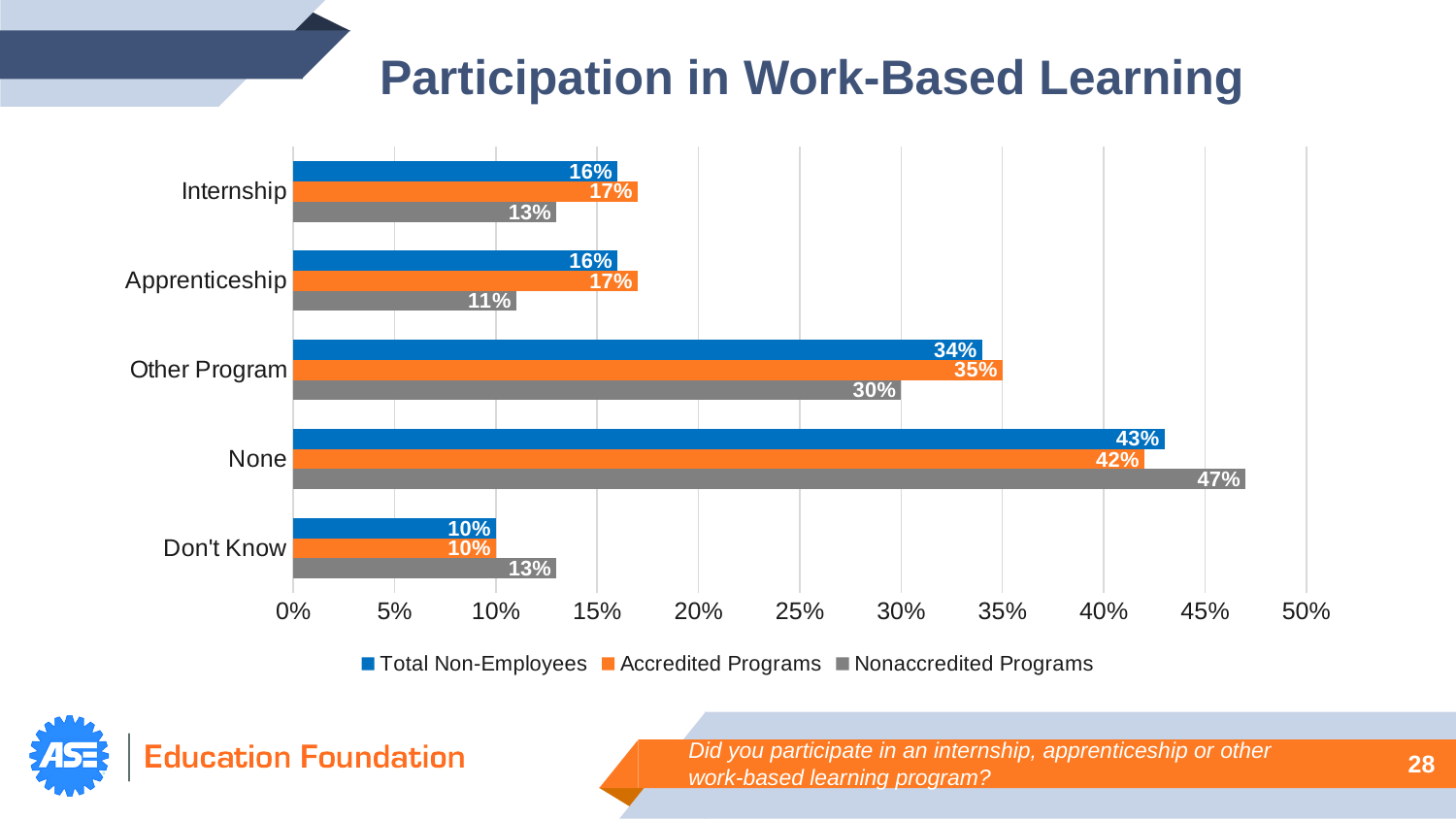
Which category has the highest value for Total Non-Employees? None Which category has the lowest value for Nonaccredited Programs? Apprenticeship Which colour represents Accredited Programs in the legend? Orange What is the value for Accredited Programs in the Apprenticeship category? 17% What is the title of the chart? Participation in Work-Based Learning How many categories are shown on the chart? 5 How many series does the legend list? 3 What is the value for Nonaccredited Programs in the None category? 47% What kind of chart is shown on the slide? Bar chart In the Internship category, which is larger: Accredited Programs or Nonaccredited Programs? Accredited Programs What is the value for Total Non-Employees in the Other Program category? 34% What is the difference between the Nonaccredited Programs and Accredited Programs values in the None category? 5%